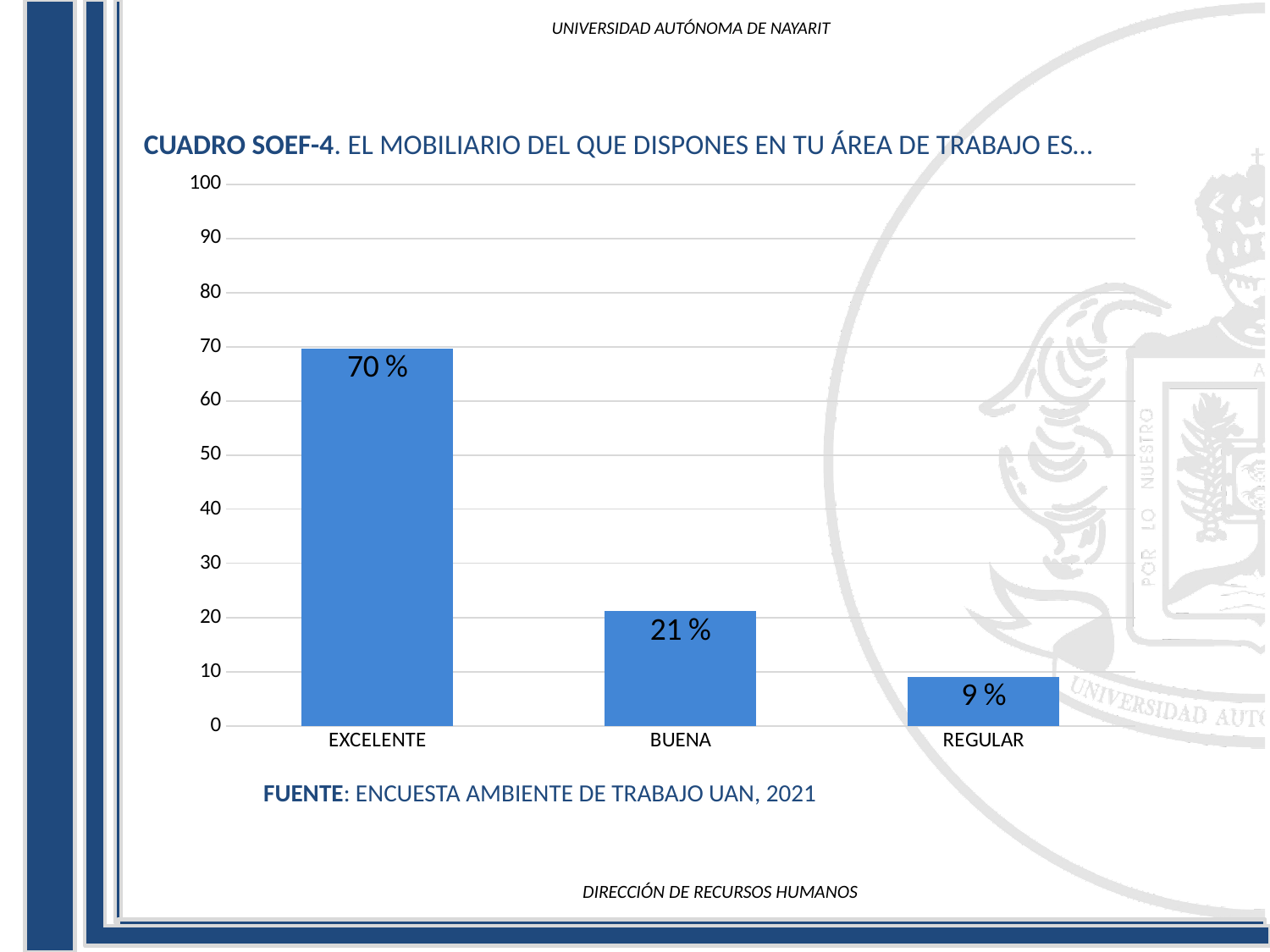
What is the difference between the values for EXCELENTE and BUENA? 49 % Which category has the highest value? EXCELENTE How many categories are shown on the x axis? 3 Which is larger, the value for BUENA or the value for REGULAR? BUENA What kind of chart is shown on the slide? bar chart What is the difference between the values for BUENA and REGULAR? 12 % What is the value for BUENA? 21 % Which category has the lowest value? REGULAR Is the value for BUENA greater or less than 30? less What source is cited below the chart? ENCUESTA AMBIENTE DE TRABAJO UAN, 2021 What is the value for EXCELENTE? 70 % What is the value for REGULAR? 9 %